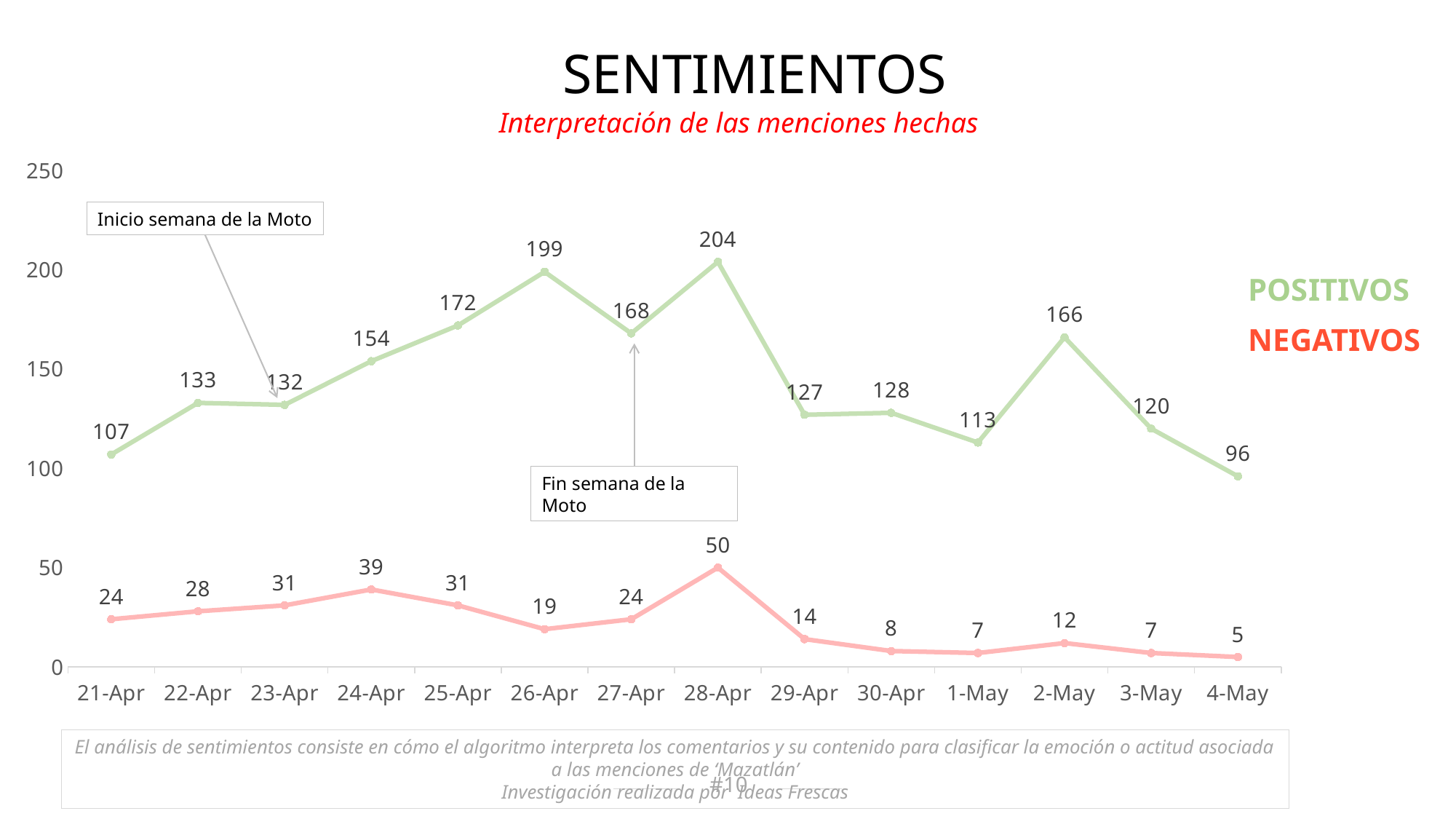
Does the NEGATIVOS series rise or fall from 28-Apr to 4-May? fall What is the POSITIVOS value on 28-Apr? 204 What is the difference between the POSITIVOS and NEGATIVOS values on 26-Apr? 180 On which date is the POSITIVOS series highest? 28-Apr What colour is the POSITIVOS line? green How many dates are plotted on the x axis? 14 How many series does the chart show? 2 What is the NEGATIVOS value on 24-Apr? 39 What kind of chart is shown on the slide? line chart On which date is the NEGATIVOS series lowest? 4-May Which is larger, the POSITIVOS value on 2-May or on 3-May? 2-May Is the POSITIVOS value on 21-Apr greater or less than 100? greater